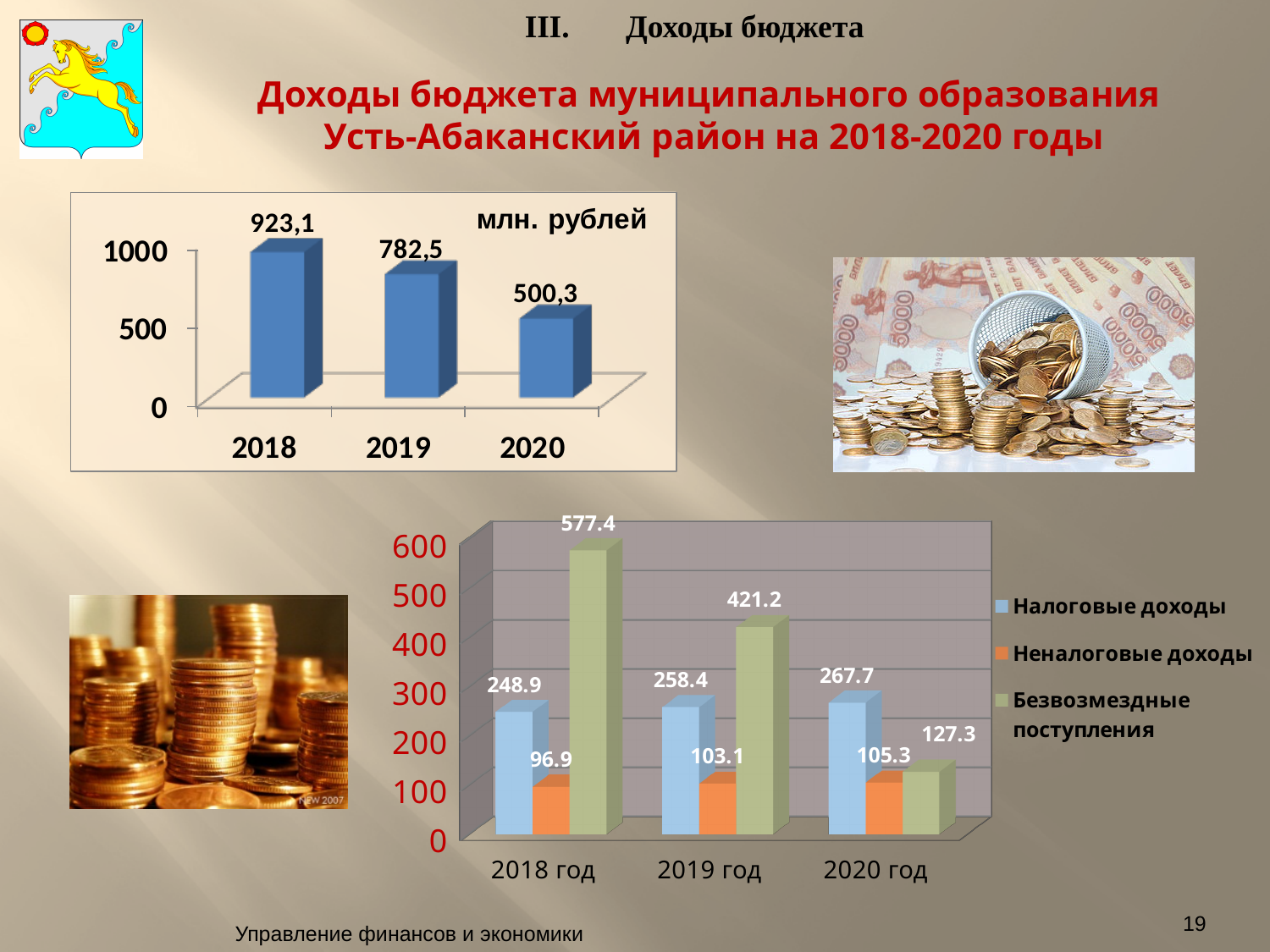
In the bottom chart, which year has the highest value for Налоговые доходы? 2020 год In the bottom chart, what is the value of Неналоговые доходы for 2019 год? 103.1 In the top-left chart, what is the value for 2018? 923,1 What kind of chart is the bottom chart? bar chart In the bottom chart, which is larger for 2020 год: Налоговые доходы or Безвозмездные поступления? Налоговые доходы In the top-left chart, do the values rise or fall from 2018 to 2020? fall In the top-left chart, what unit is shown in the chart? млн. рублей In the top-left chart, which year has the lowest value? 2020 In the bottom chart, what is the difference between Безвозмездные поступления in 2018 год and 2019 год? 156.2 In the bottom chart, how many series does the legend list? 3 In the bottom chart, what is the value of Безвозмездные поступления for 2018 год? 577.4 In the top-left chart, what is the difference between the 2018 and 2020 values? 422,8